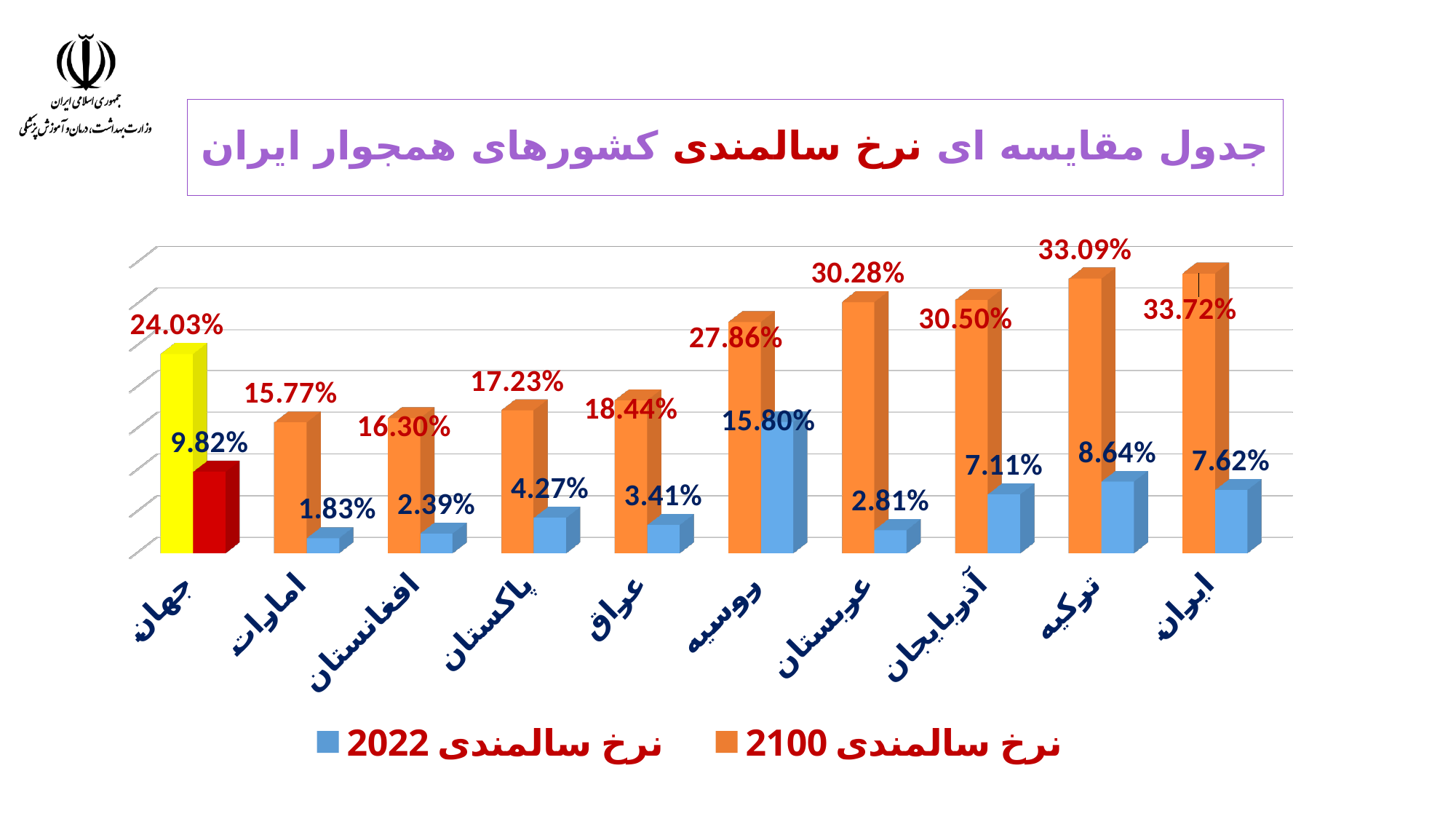
What is the difference between the 2100 and 2022 aging rates for ترکیه? 24.45% How many series does the legend list? 2 Which category has the lowest 2022 aging rate? امارات Which category has the highest 2100 aging rate? ایران What kind of chart is shown on the slide? bar chart Which colour represents the نرخ سالمندی 2100 series in the legend? orange What is the 2022 aging rate shown for جهان? 9.82% What is the 2022 aging rate (نرخ سالمندی 2022) shown for روسیه? 15.80% What is the 2100 aging rate (نرخ سالمندی 2100) shown for ایران? 33.72% What is the 2100 aging rate shown for عربستان? 30.28% How many categories are shown on the x axis? 10 Which is larger: the 2022 aging rate for آذربایجان or for ایران? ایران